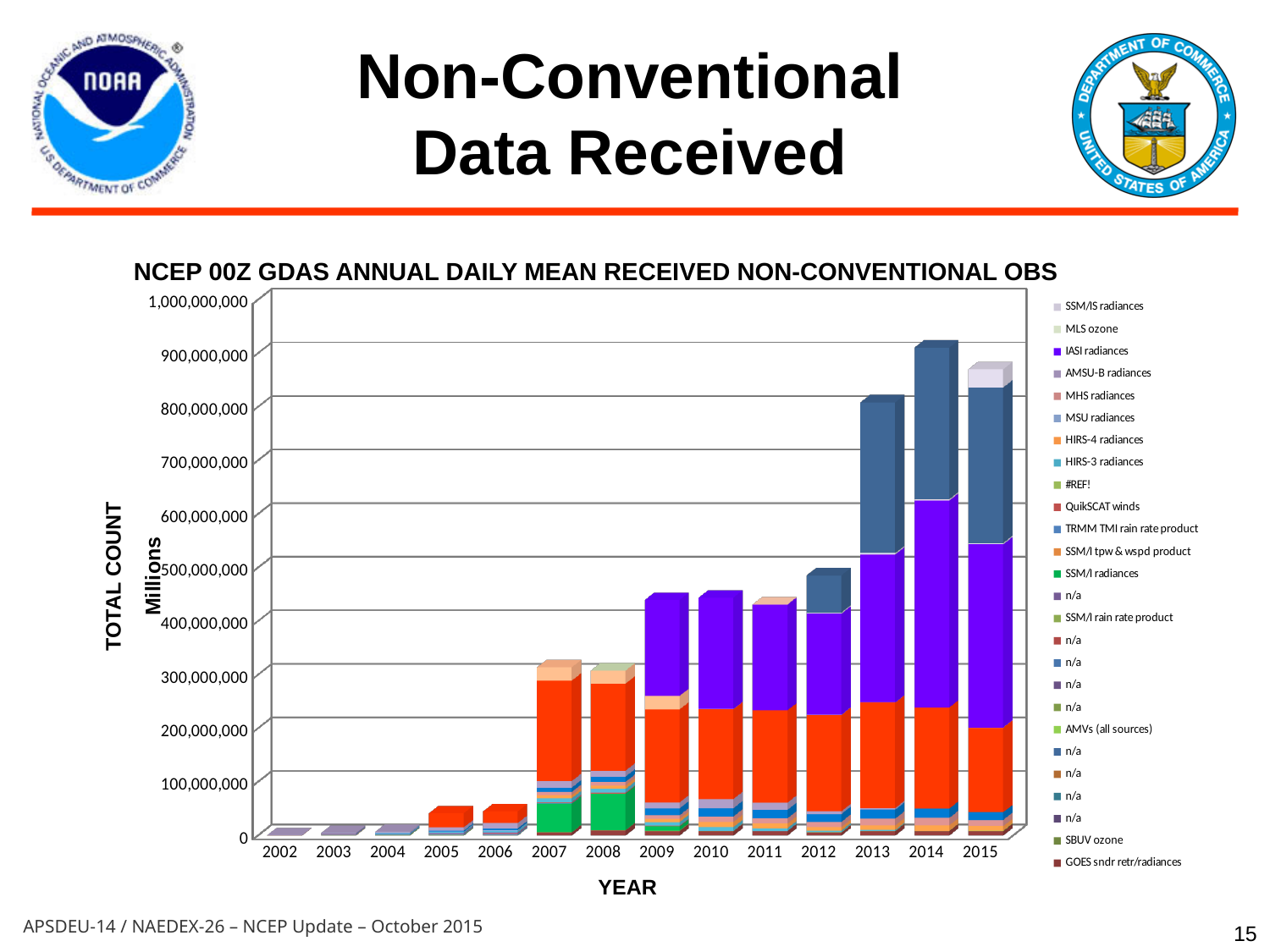
Is the total count for 2015 greater or less than 800,000,000? greater Is the total count for 2009 greater or less than 500,000,000? less Is the total count for 2013 greater or less than 700,000,000? greater Which year has the larger total count, 2014 or 2015? 2014 What is the title of the chart? NCEP 00Z GDAS ANNUAL DAILY MEAN RECEIVED NON-CONVENTIONAL OBS Overall, does the total count rise or fall from 2002 to 2015? Rise What kind of chart is shown on the slide? Stacked bar chart Which year has the larger total count, 2008 or 2009? 2009 What is the label on the x axis of the chart? YEAR How many years are shown on the x axis of the chart? 14 Which year has the highest total count in the chart? 2014